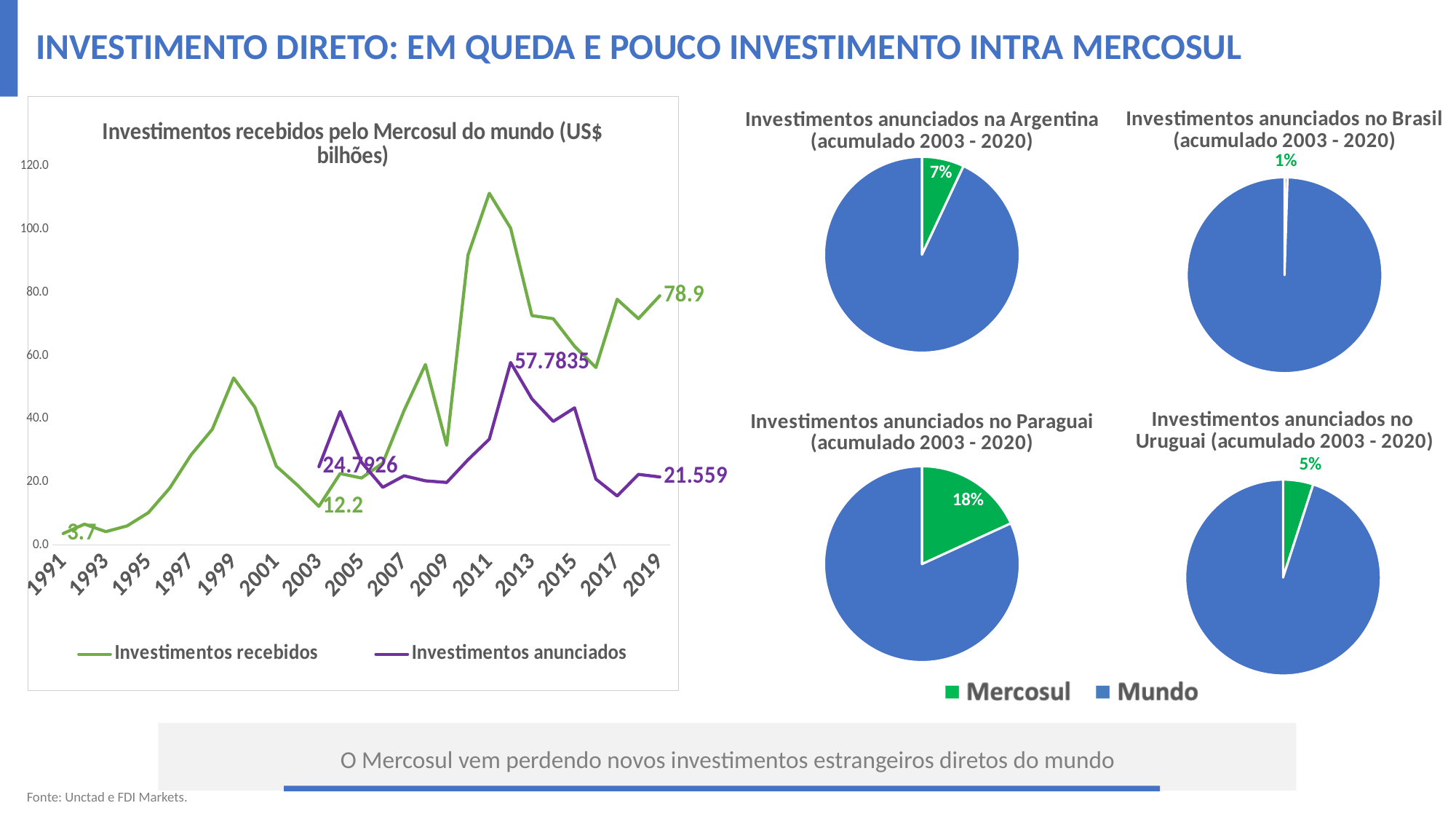
In the pie chart 'Investimentos anunciados na Argentina (acumulado 2003 - 2020)', what share is Mercosul? 7% In the pie chart 'Investimentos anunciados no Paraguai (acumulado 2003 - 2020)', what share is Mercosul? 18% In the line chart 'Investimentos recebidos pelo Mercosul do mundo', what is the labelled peak value of the Investimentos anunciados series? 57.7835 In the line chart 'Investimentos recebidos pelo Mercosul do mundo', is the value for Investimentos recebidos in 2011 greater or less than 100? greater In the line chart 'Investimentos recebidos pelo Mercosul do mundo', what is the difference between the 2019 labelled values of Investimentos recebidos (78.9) and Investimentos anunciados (21.559)? 57.341 Among the four pie charts, which country has the largest Mercosul share of announced investments? Paraguai How many series does the legend of the line chart 'Investimentos recebidos pelo Mercosul do mundo' list? 2 In the line chart 'Investimentos recebidos pelo Mercosul do mundo', what is the labelled value of Investimentos anunciados in 2019? 21.559 In the line chart 'Investimentos recebidos pelo Mercosul do mundo', what is the labelled value of Investimentos recebidos at the end of the series in 2019? 78.9 What kind of chart is 'Investimentos recebidos pelo Mercosul do mundo (US$ bilhões)'? Line chart In the pie chart 'Investimentos anunciados no Brasil (acumulado 2003 - 2020)', what share is Mercosul? 1% In the line chart 'Investimentos recebidos pelo Mercosul do mundo', what is the labelled value of Investimentos recebidos in 1991? 3.7